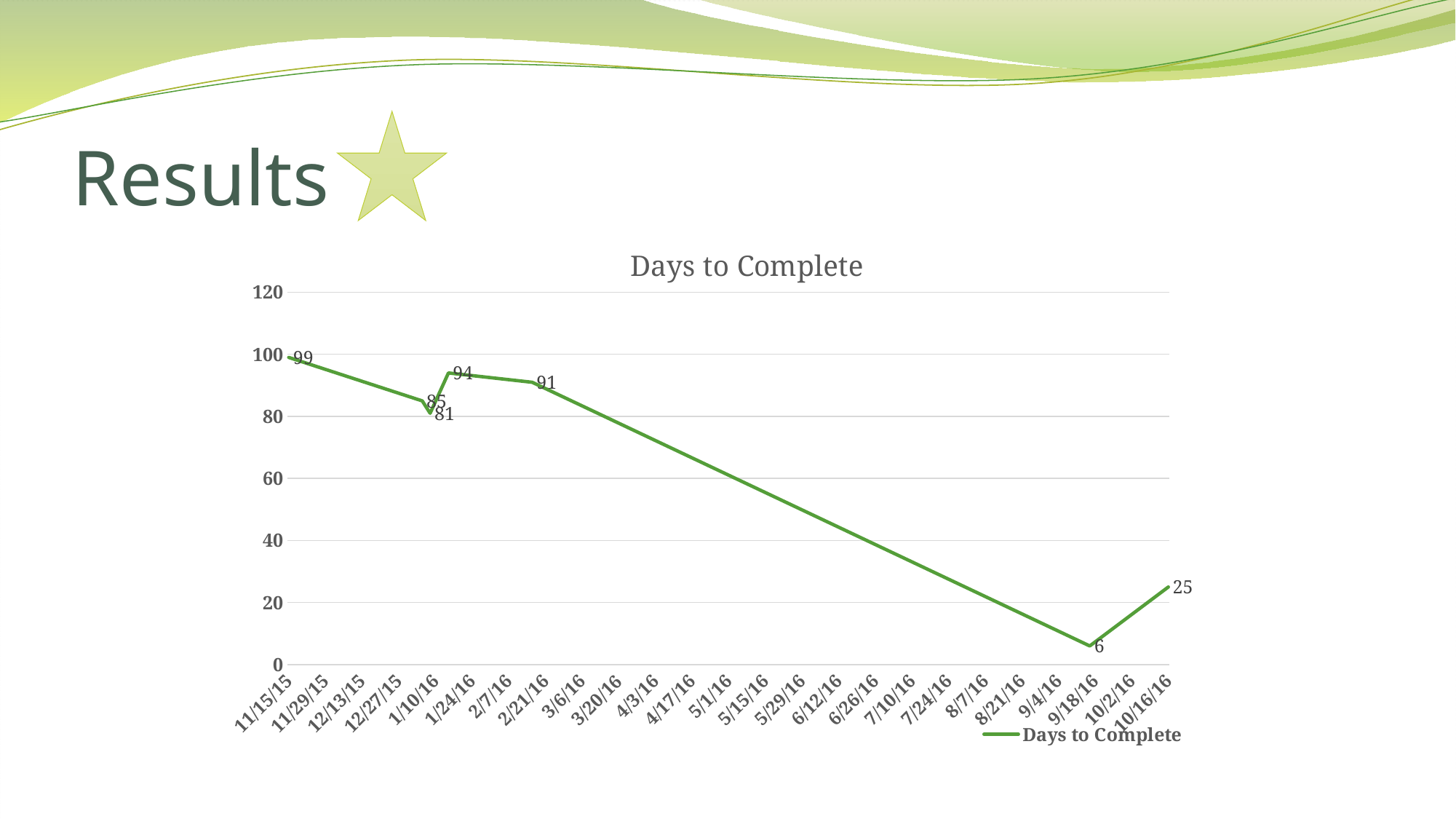
What is the value for Days to Complete at 10/16/16? 25 Which date has the highest Days to Complete value? 11/15/15 Overall, do the Days to Complete values rise or fall from 11/15/15 to 9/18/16? fall What is the value for Days to Complete at 11/15/15? 99 What is the title of the chart? Days to Complete Is the Days to Complete value at 5/15/16 greater or less than 80? less What kind of chart is shown on the slide? line chart How many series does the legend list? 1